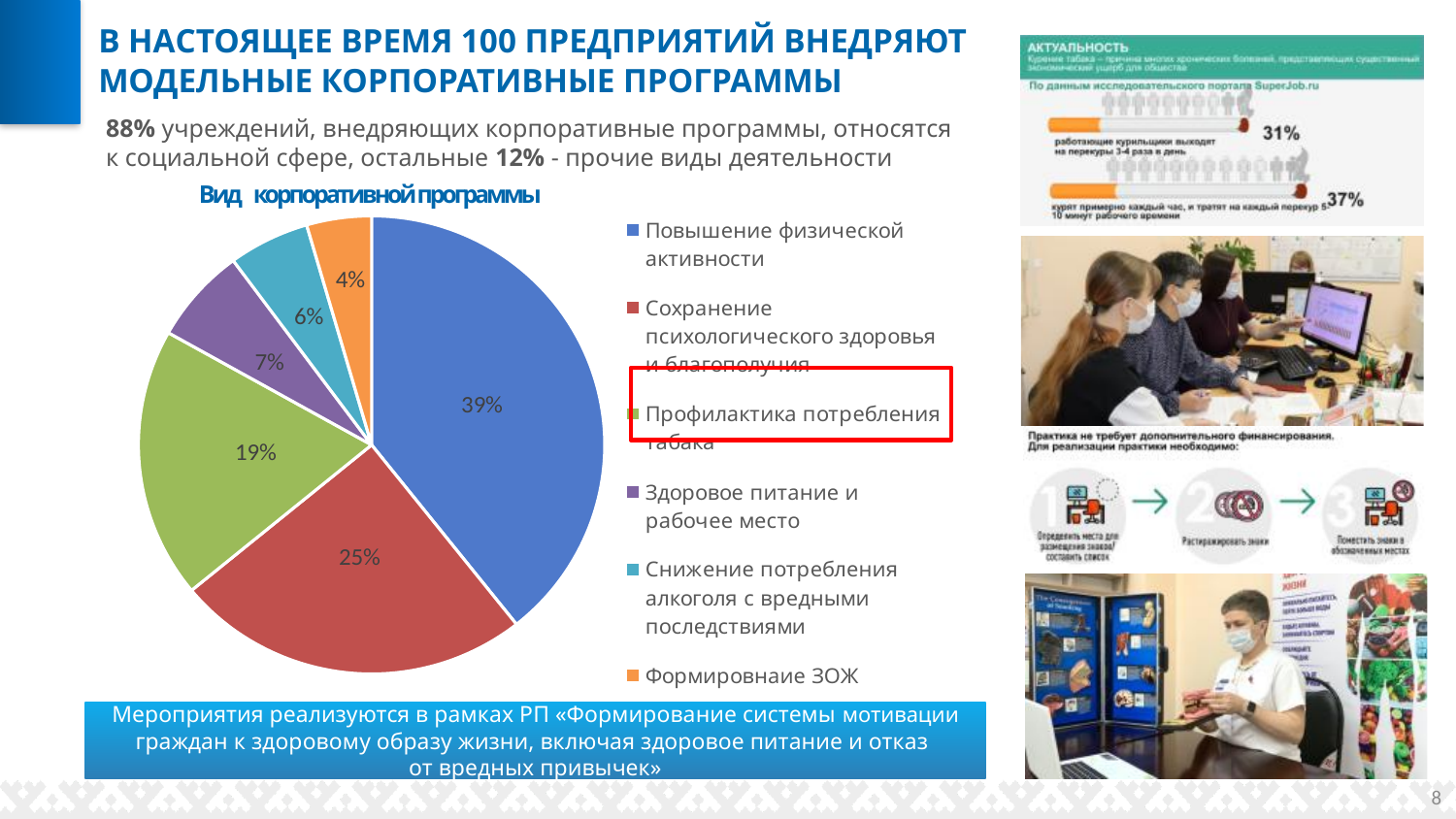
Which type of corporate programme has the smallest share in the pie chart? Формировнаие ЗОЖ What kind of chart is shown under the heading «Вид корпоративной программы»? pie chart What share of the pie chart does «Повышение физической активности» take? 39% What percentage is shown for «Здоровое питание и рабочее место»? 7% What is the difference in percentage points between «Повышение физической активности» and «Сохранение психологического здоровья и благополучия»? 14 Which has a larger share: «Профилактика потребления табака» or «Здоровое питание и рабочее место»? Профилактика потребления табака What percentage is shown for «Снижение потребления алкоголя с вредными последствиями»? 6% Which type of corporate programme has the largest share in the pie chart? Повышение физической активности What percentage is shown for «Профилактика потребления табака»? 19% How many slices does the pie chart have? 6 What colour is the slice for «Профилактика потребления табака»? green What percentage is shown for «Сохранение психологического здоровья и благополучия»? 25%